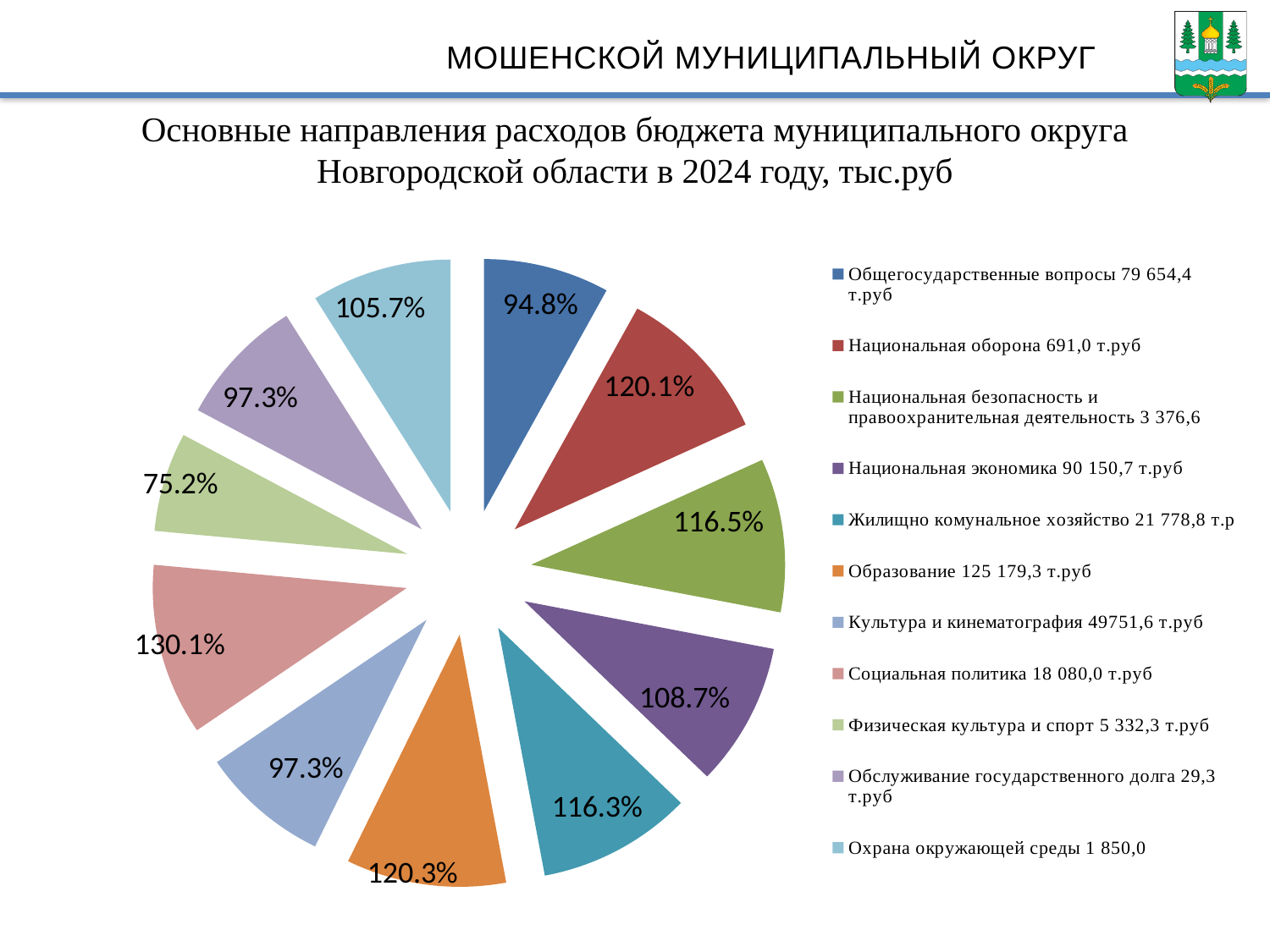
What type of chart is shown on the slide? pie chart What percentage label is shown on the slice for Общегосударственные вопросы? 94.8% How many slices does the pie chart have? 11 According to the legend, what is the amount for Образование? 125 179,3 т.руб Which category has the highest percentage label on the pie chart? Социальная политика What is the difference between the percentage labels for Социальная политика and Физическая культура и спорт? 54.9 percentage points What percentage label is shown on the slice for Социальная политика? 130.1% How many entries does the legend list? 11 What percentage label is shown on the slice for Физическая культура и спорт? 75.2% Which category has the lowest percentage label on the pie chart? Физическая культура и спорт What percentage label is shown on the slice for Образование? 120.3% Which has the larger percentage label: Национальная экономика or Жилищно коммунальное хозяйство? Жилищно коммунальное хозяйство